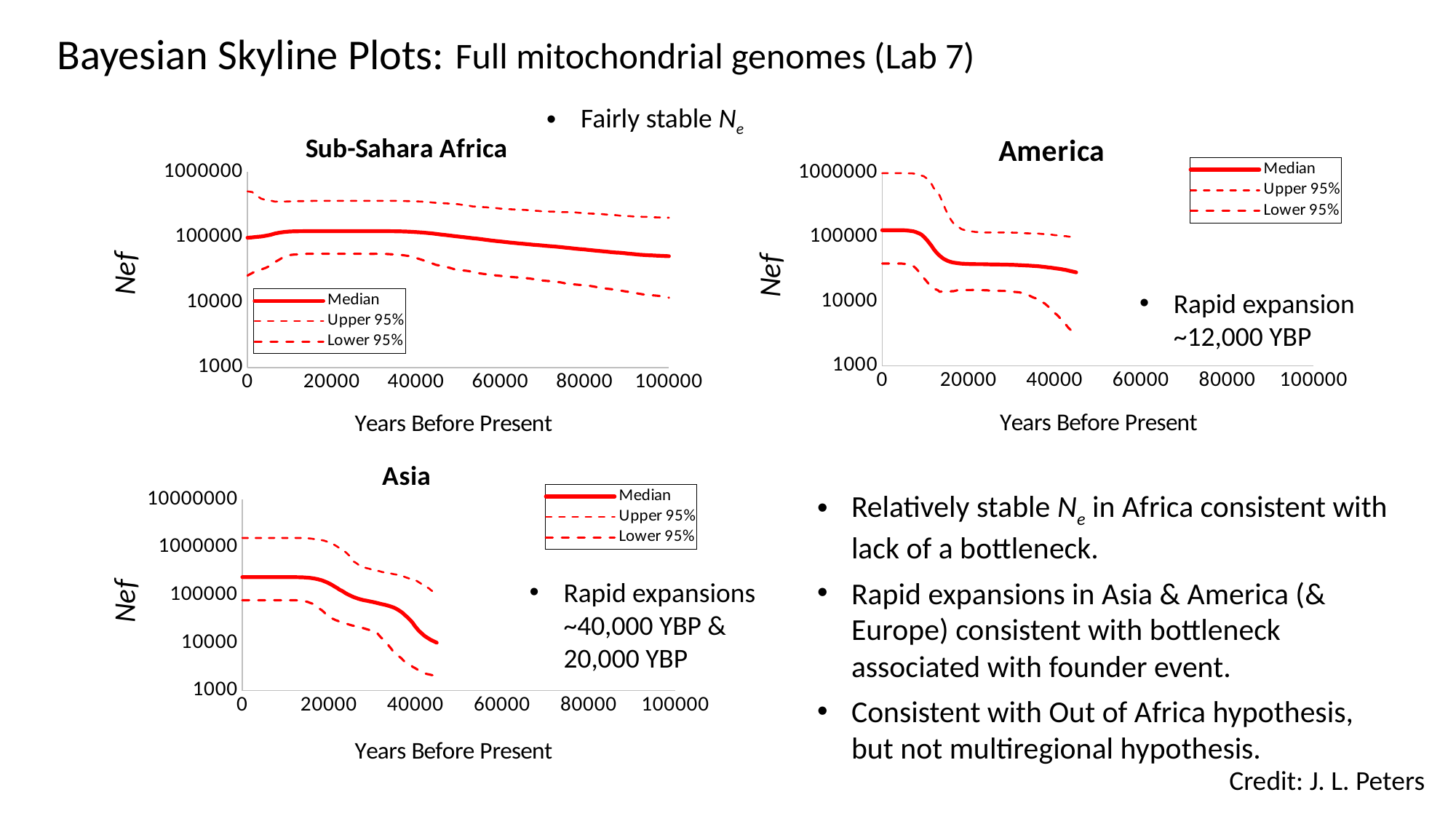
In the America chart, is the Lower 95% value at its right-hand end (about 45000 Years Before Present) greater or less than 10000? less What kind of chart is the Sub-Sahara Africa chart? line chart Which chart has the higher Median value at 0 Years Before Present: Asia or America? Asia What is the x-axis label on the America chart? Years Before Present In the Asia chart, is the Lower 95% value at about 45000 Years Before Present greater or less than 10000? less In the America chart, is the Median value at 40000 Years Before Present greater or less than 100000? less In the Asia chart, which is larger: the Median value at 0 Years Before Present or at 40000 Years Before Present? 0 Years Before Present In the Asia chart, does the Median line rise or fall as Years Before Present increases from 20000 to 40000? fall How many series does the legend of the America chart list? 3